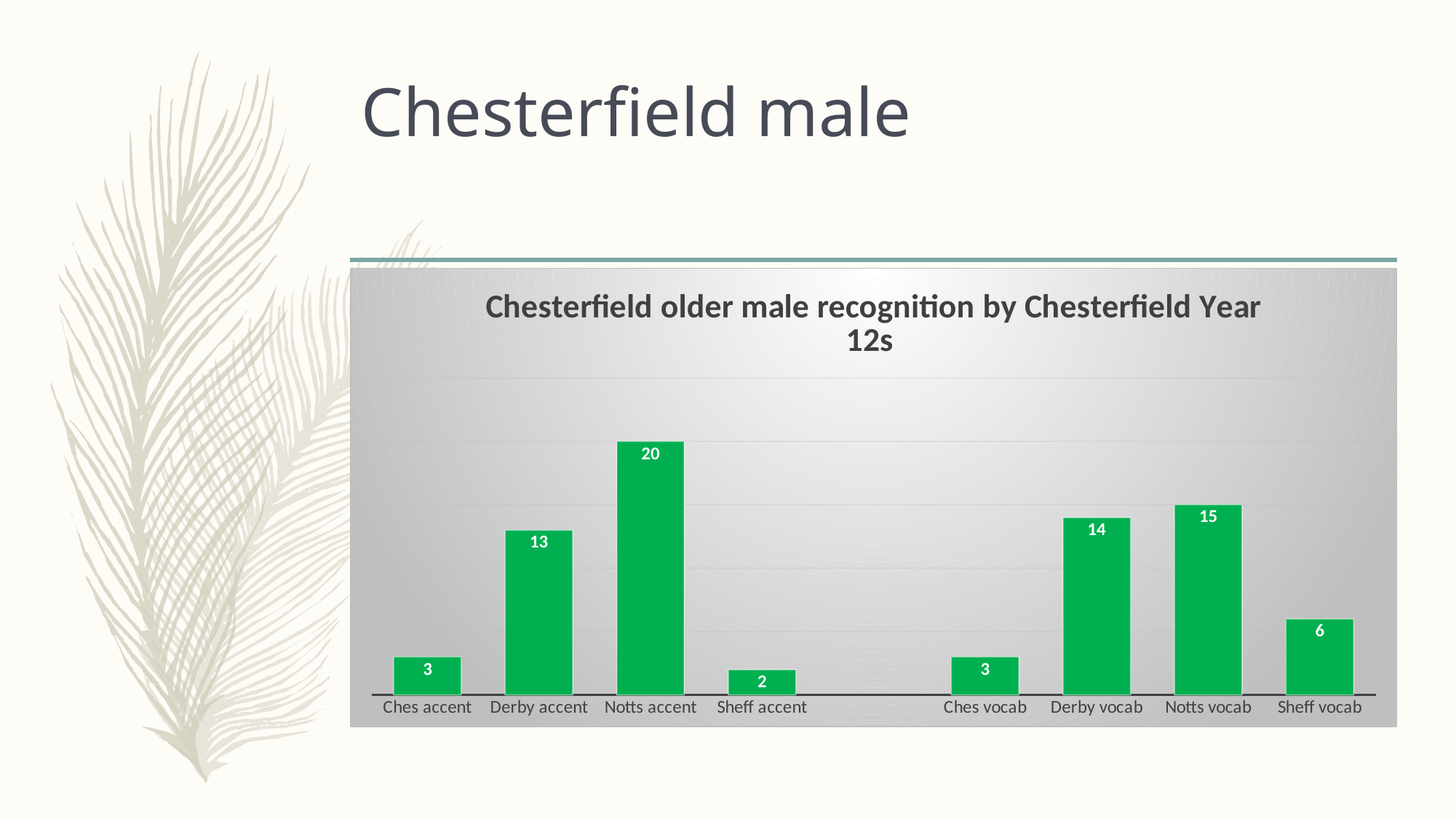
Which is larger, the value for Notts vocab or the value for Derby accent? Notts vocab What is the value for Sheff vocab? 6 Which category has the lowest value? Sheff accent What is the value for Derby vocab? 14 How many categories are shown on the x axis? 8 What is the difference between the values for Derby accent and Sheff accent? 11 What is the difference between the values for Notts accent and Notts vocab? 5 Which category has the highest value? Notts accent What is the value for Notts accent? 20 What is the title of the chart? Chesterfield older male recognition by Chesterfield Year 12s What kind of chart is shown on the slide? Bar chart Which is larger, the value for Derby vocab or the value for Sheff vocab? Derby vocab